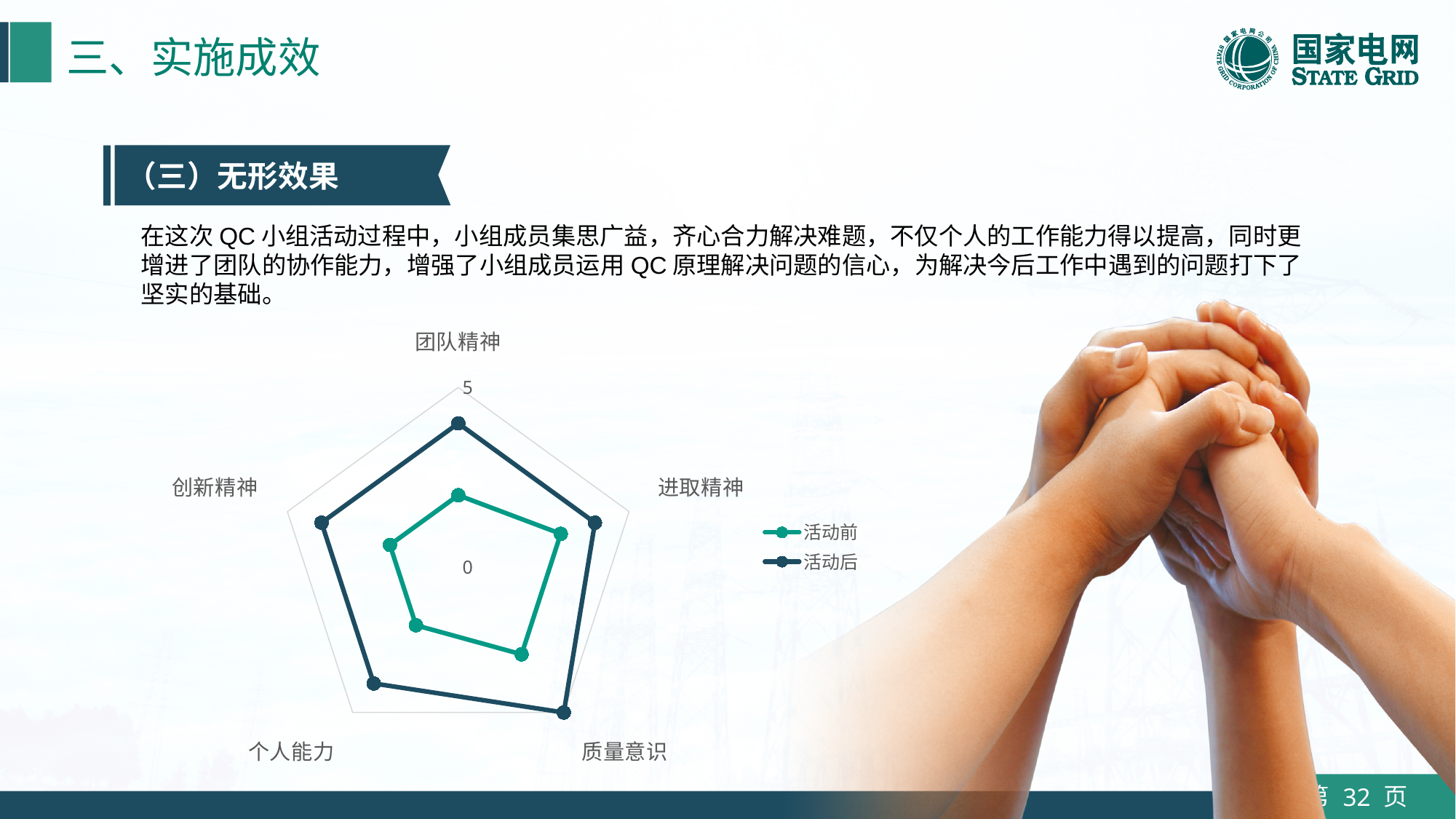
What are the two series named in the legend of the radar chart? 活动前 and 活动后 Which series is drawn in green on the radar chart? 活动前 For 团队精神, which series has the larger value, 活动前 or 活动后? 活动后 What is the maximum value shown on the radar chart's axis scale? 5 How many categories (axes) does the radar chart have? 5 For 个人能力, which series has the larger value, 活动前 or 活动后? 活动后 Is the 活动后 value for 团队精神 greater or less than 5? less How many series does the legend of the radar chart list? 2 For 创新精神, which series has the larger value, 活动前 or 活动后? 活动后 What kind of chart is shown on the slide? radar chart Is the 活动前 value for 团队精神 greater or less than 5? less